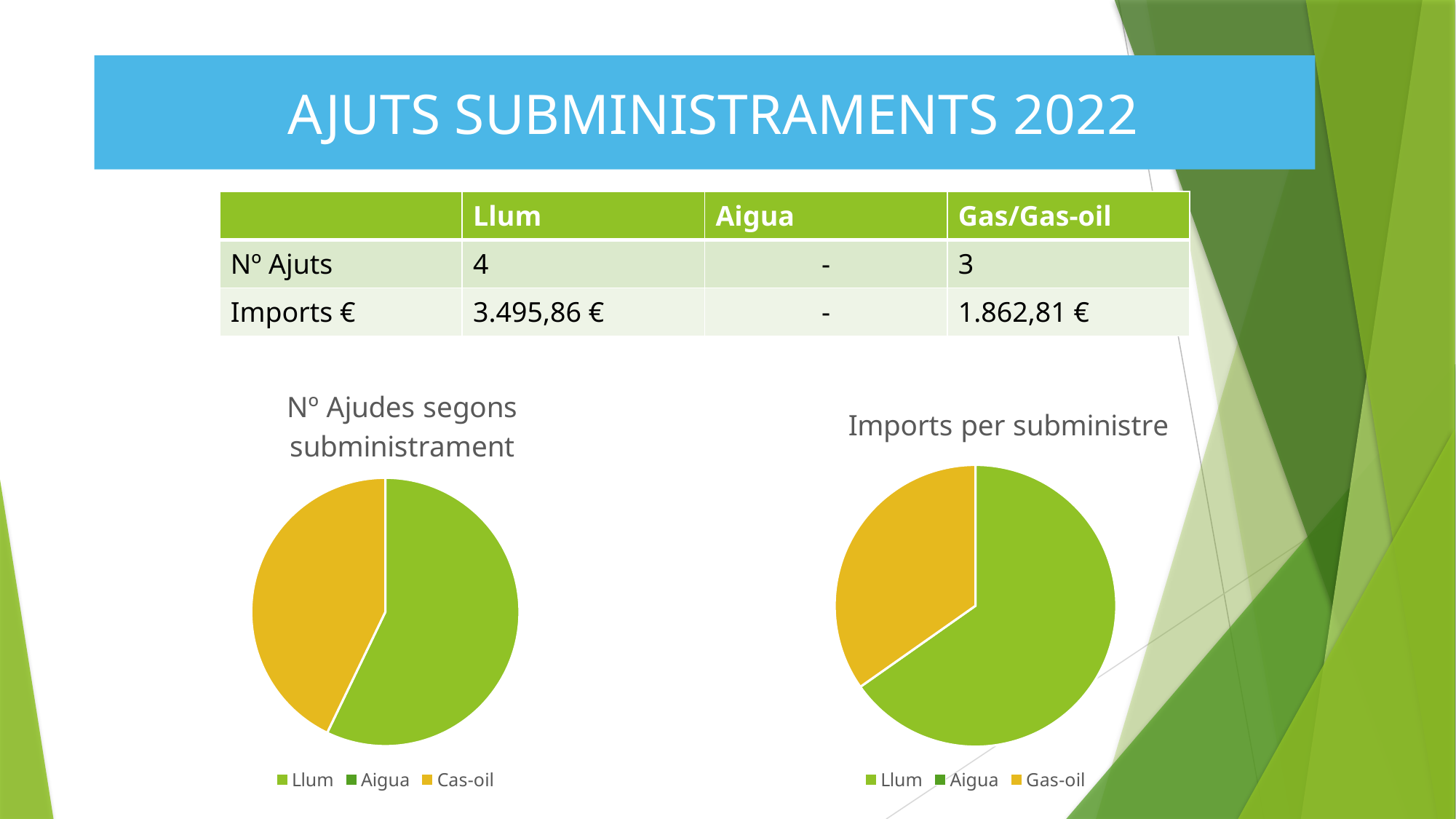
What is the title of the pie chart on the right of the slide? Imports per subministre In the 'Nº Ajudes segons subministrament' chart, which category has the largest slice? Llum In the 'Nº Ajudes segons subministrament' chart, how many more ajuts are there for Llum than for Gas/Gas-oil? 1 How many entries does the legend of the 'Nº Ajudes segons subministrament' chart list? 3 In the 'Imports per subministre' chart, which slice is larger, Llum or Gas-oil? Llum In the 'Imports per subministre' chart, which category has the largest slice? Llum What kind of chart is the 'Imports per subministre' chart on the right? Pie chart In the 'Imports per subministre' chart, what colour is the Gas-oil slice? Yellow How many entries does the legend of the 'Imports per subministre' chart list? 3 In the 'Nº Ajudes segons subministrament' chart, how many ajuts does the Llum slice represent according to the table? 4 What kind of chart is the 'Nº Ajudes segons subministrament' chart on the left? Pie chart In the 'Imports per subministre' chart, what amount does the Gas-oil slice represent according to the table? 1.862,81 €